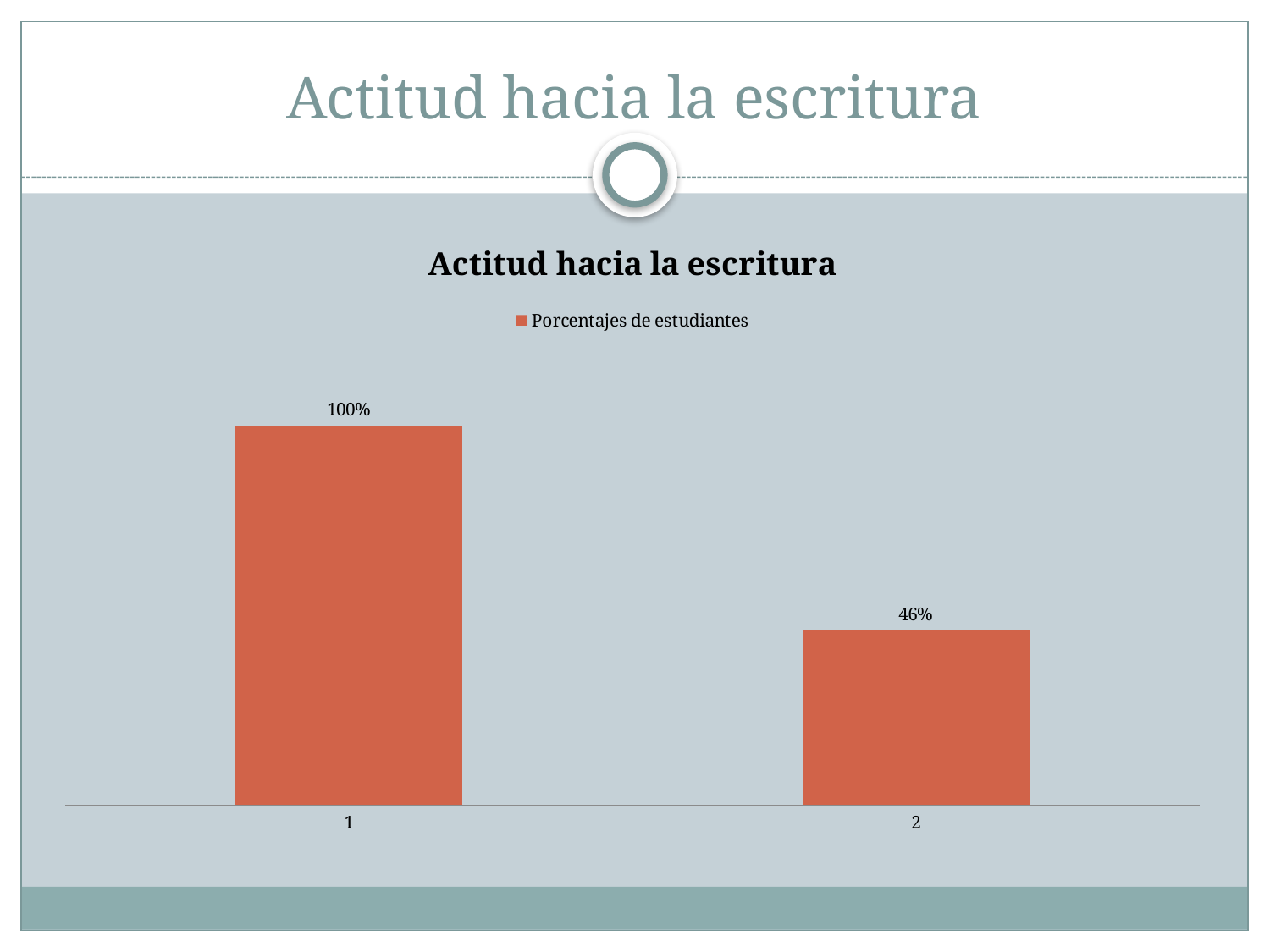
What series name does the legend show? Porcentajes de estudiantes What is the difference between the values for category 1 and category 2? 54% What kind of chart is shown? bar chart Which category has the lowest value? 2 Which category has the highest value? 1 What is the value for category 1? 100% How many categories are shown on the x axis? 2 What is the title of the chart? Actitud hacia la escritura Do the values rise or fall from category 1 to category 2? fall Which is larger, the value for category 1 or category 2? 1 What is the value for category 2? 46% How many series does the legend list? 1